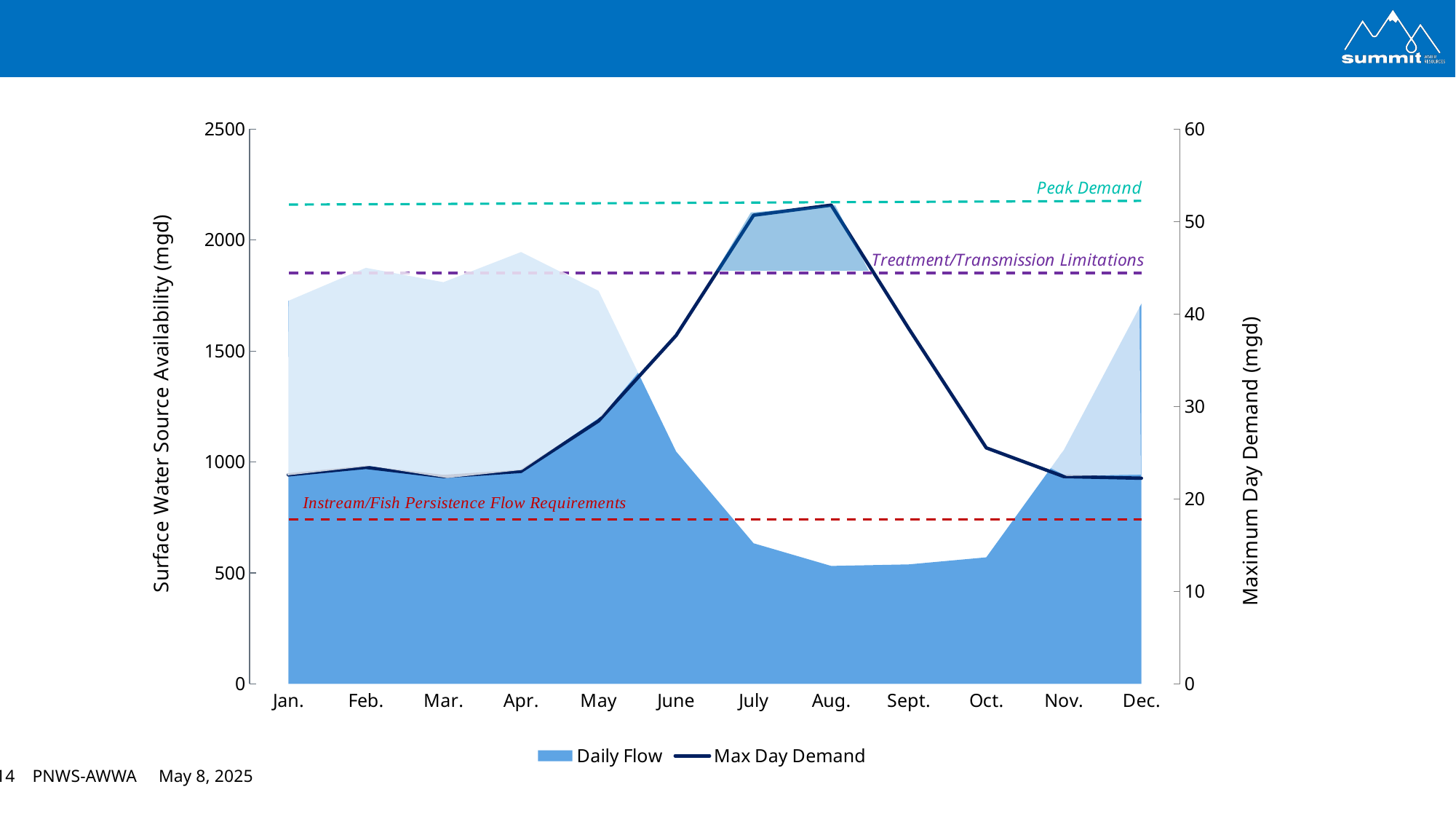
Is the Daily Flow value for Aug. greater or less than 1000? less Is the Daily Flow value for Apr. greater or less than 1500? greater How many series does the chart legend list? 2 In which month is Max Day Demand highest? Aug. Which month has the larger Daily Flow, Jan. or June? Jan. Does Max Day Demand rise or fall from Aug. to Dec.? fall Is the Max Day Demand value for Jan. greater or less than 30? less How many months are shown along the x axis of the chart? 12 What kind of chart is shown on the slide? Area chart with a line series What is the label of the left vertical axis? Surface Water Source Availability (mgd)